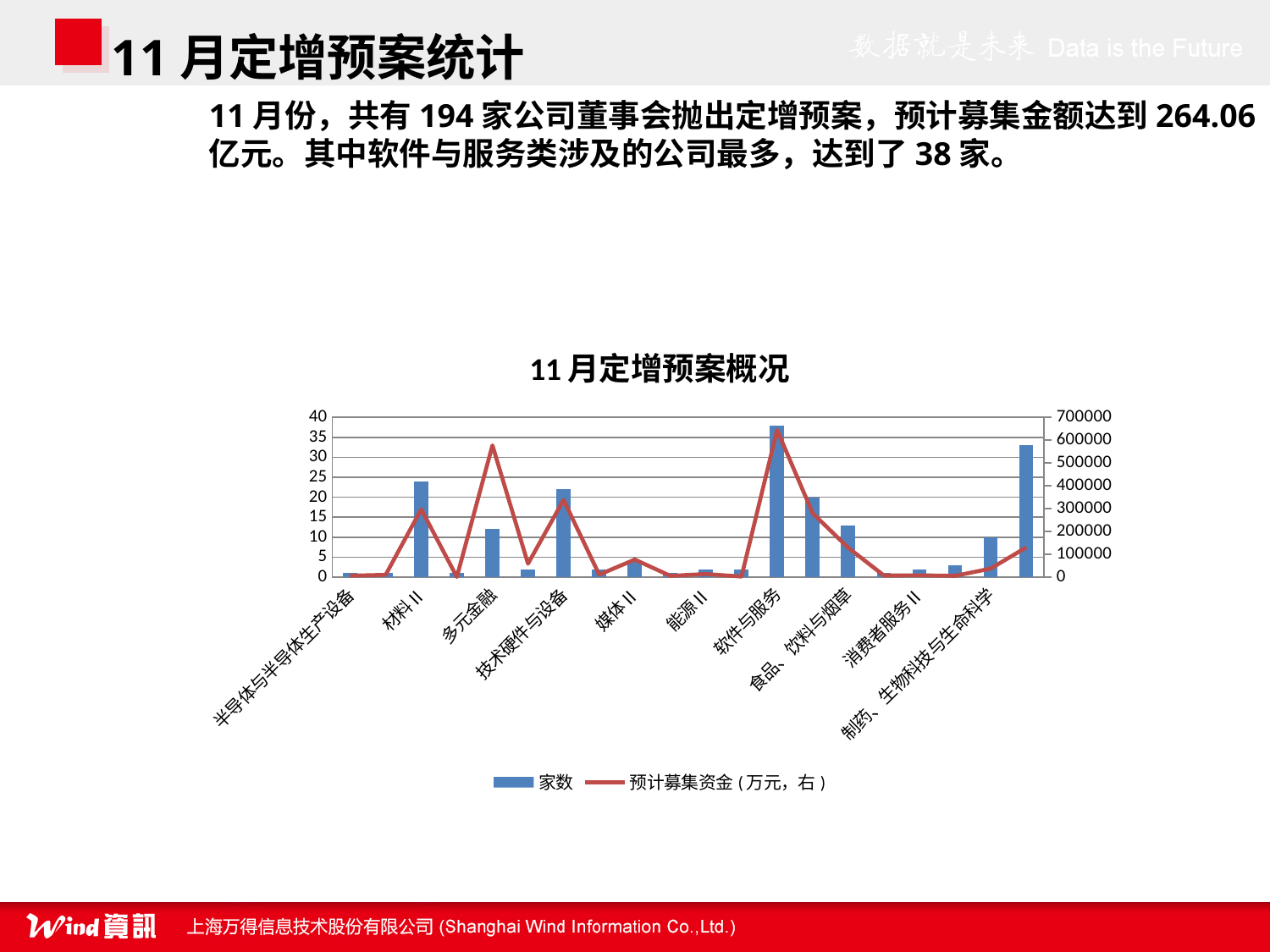
What is the 家数 value for 软件与服务? 38 Is the 家数 value for 技术硬件与设备 greater or less than 20? greater Is the 家数 value for 媒体II greater or less than 5? less Which series is plotted as the red line? 预计募集资金(万元，右) Which has the larger 家数 bar, 材料II or 多元金融? 材料II What is the title of the chart on the slide? 11月定增预案概况 How many series does the chart legend list? 2 Is the 预计募集资金 value for 多元金融 greater or less than 500000? greater What kind of chart is shown on the slide? Combined bar and line chart Which category has the highest 家数 bar? 软件与服务